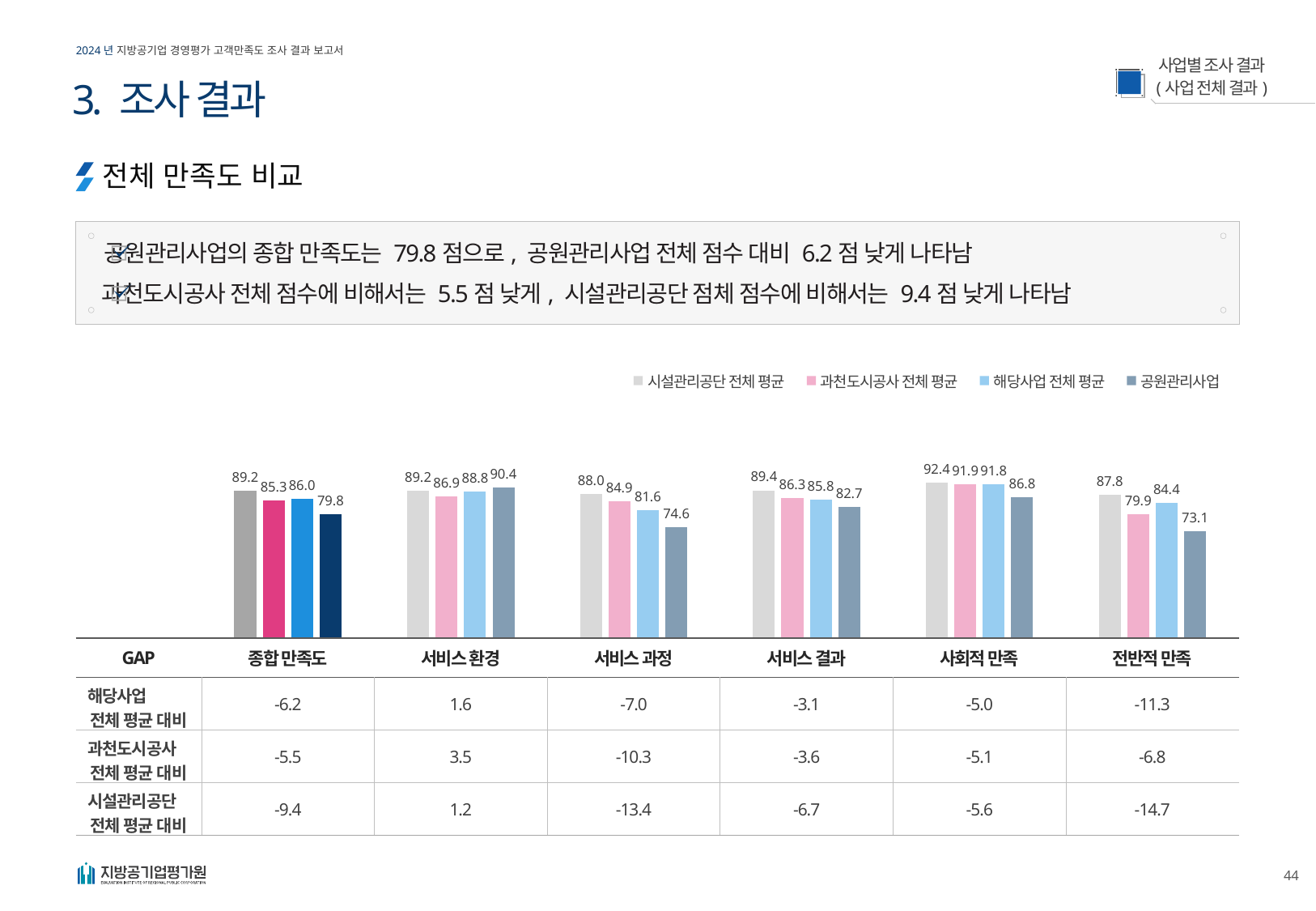
What is the difference between 시설관리공단 전체 평균 and 공원관리사업 for 서비스 과정? 13.4 What is the value of 공원관리사업 for 종합 만족도? 79.8 What is the value of 과천도시공사 전체 평균 for 전반적 만족? 79.9 How many series does the chart legend list? 4 In which category does 공원관리사업 have its lowest value? 전반적 만족 For 서비스 환경, which is larger: 공원관리사업 or 시설관리공단 전체 평균? 공원관리사업 In which category does 공원관리사업 have its highest value? 서비스 환경 What is the value of 시설관리공단 전체 평균 for 사회적 만족? 92.4 What kind of chart is shown on the slide? Bar chart What is the last series listed in the chart legend? 공원관리사업 How many categories are shown on the x axis of the chart? 6 What is the value of 해당사업 전체 평균 for 서비스 과정? 81.6